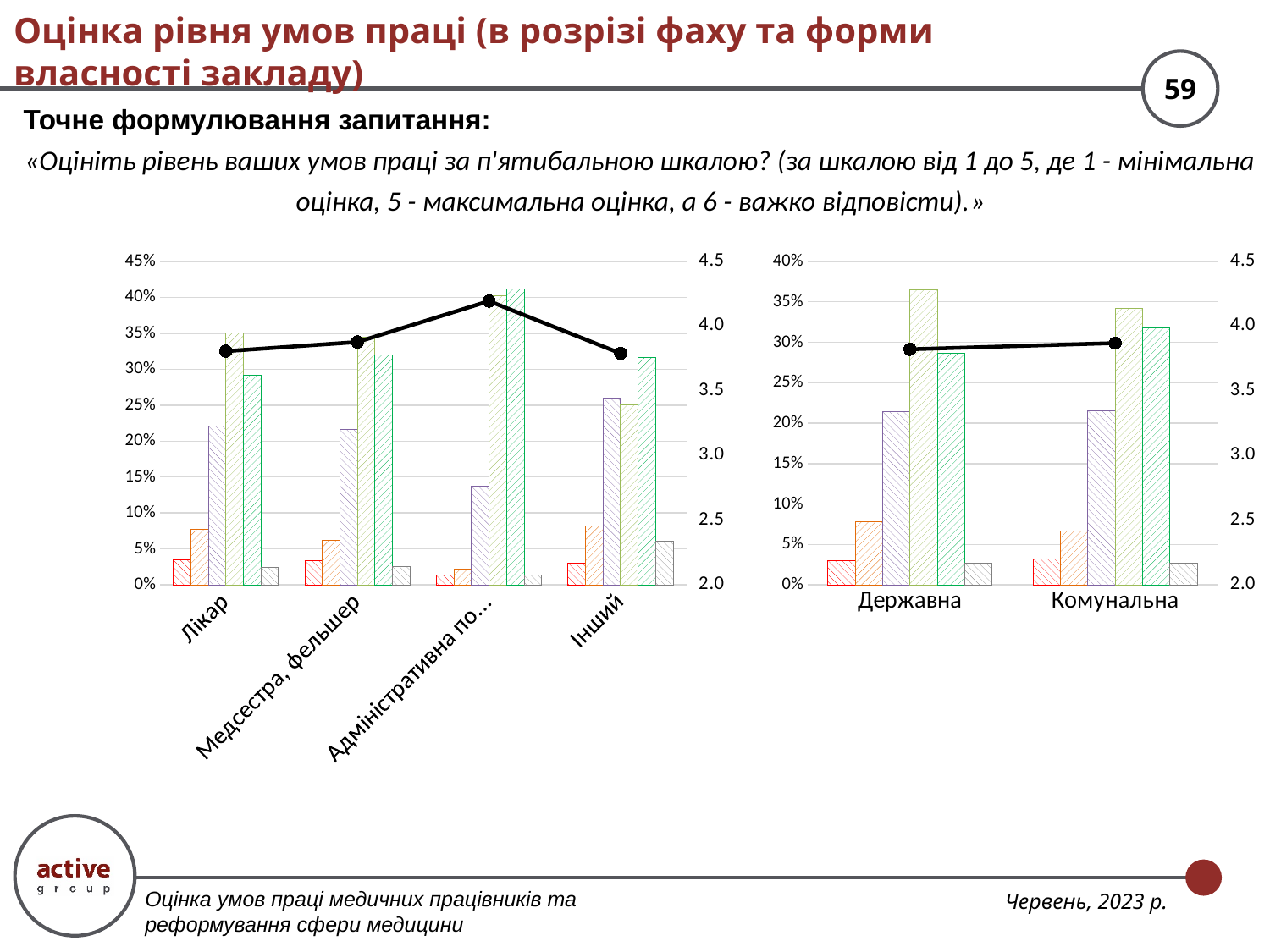
What is the maximum value shown on the left-hand percentage axis of the right chart? 40% In the left chart, for which category does the line reach its highest point? Адміністративна по... In the left chart, is the line value for Адміністративна по... greater or less than 4.0 on the right axis? greater How many charts are on the slide? 2 In the right chart, how many categories are shown on the x axis? 2 In the left chart, is the tallest bar for Адміністративна по... greater or less than 35%? greater In the right chart, is the line value for Державна greater or less than 4.0 on the right axis? less In the left chart, how many categories are shown on the x axis? 4 What kind of chart is the left chart? bar chart with a line